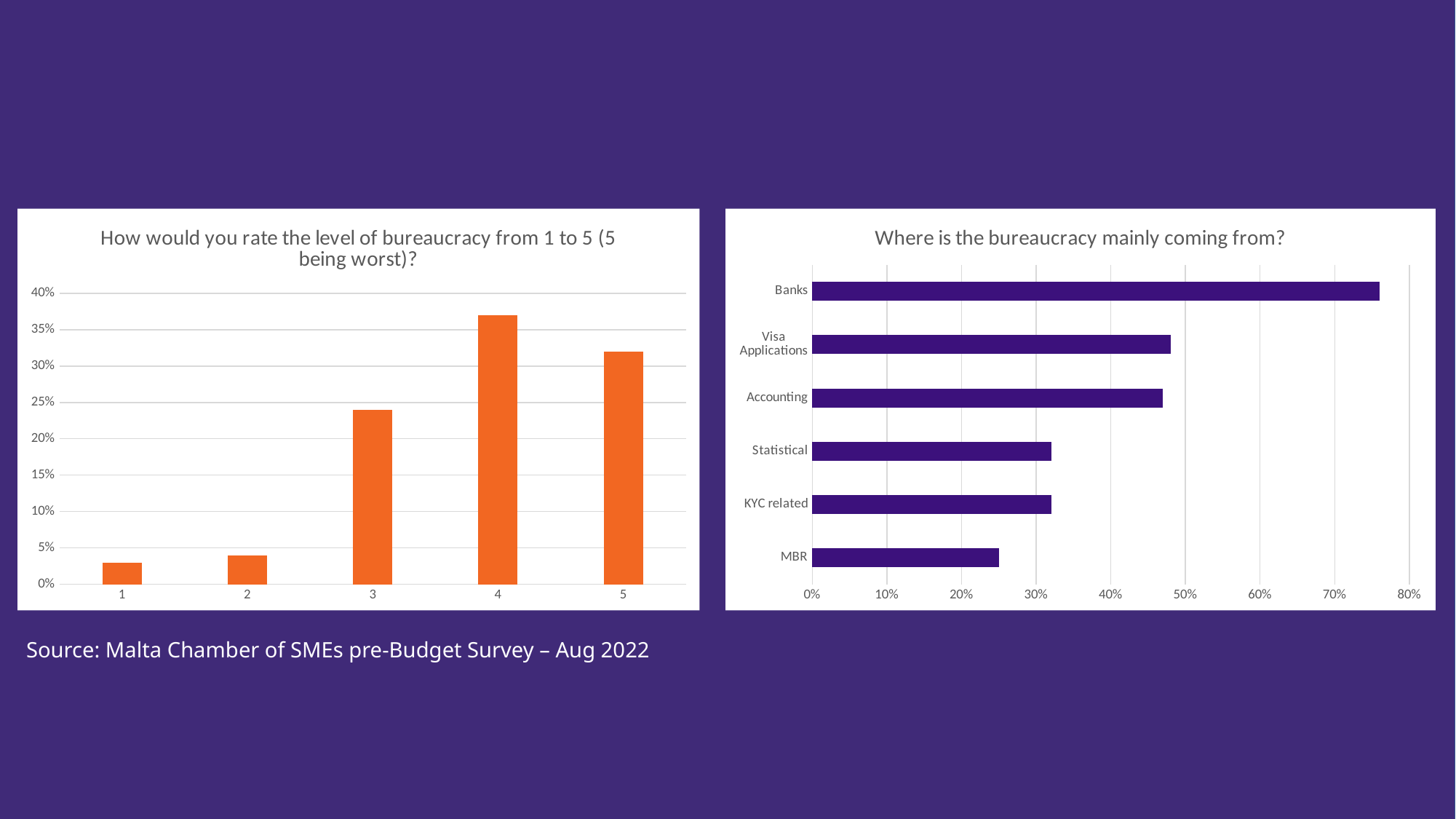
In the chart titled "How would you rate the level of bureaucracy from 1 to 5 (5 being worst)?", how many rating categories are shown on the x axis? 5 In the chart titled "Where is the bureaucracy mainly coming from?", how many sources of bureaucracy are listed? 6 In the chart titled "How would you rate the level of bureaucracy from 1 to 5 (5 being worst)?", which rating has the highest share of responses? 4 In the chart titled "Where is the bureaucracy mainly coming from?", is the value for Banks greater or less than 70%? greater In the chart titled "How would you rate the level of bureaucracy from 1 to 5 (5 being worst)?", is the value for rating 1 greater or less than 5%? less In the chart titled "How would you rate the level of bureaucracy from 1 to 5 (5 being worst)?", is the value for rating 4 greater or less than 35%? greater In the chart titled "Where is the bureaucracy mainly coming from?", which source has the highest value? Banks What kind of chart is the chart titled "Where is the bureaucracy mainly coming from?"? bar chart In the chart titled "How would you rate the level of bureaucracy from 1 to 5 (5 being worst)?", which is larger, the value for rating 4 or rating 5? rating 4 In the chart titled "Where is the bureaucracy mainly coming from?", which source has the lowest value? MBR